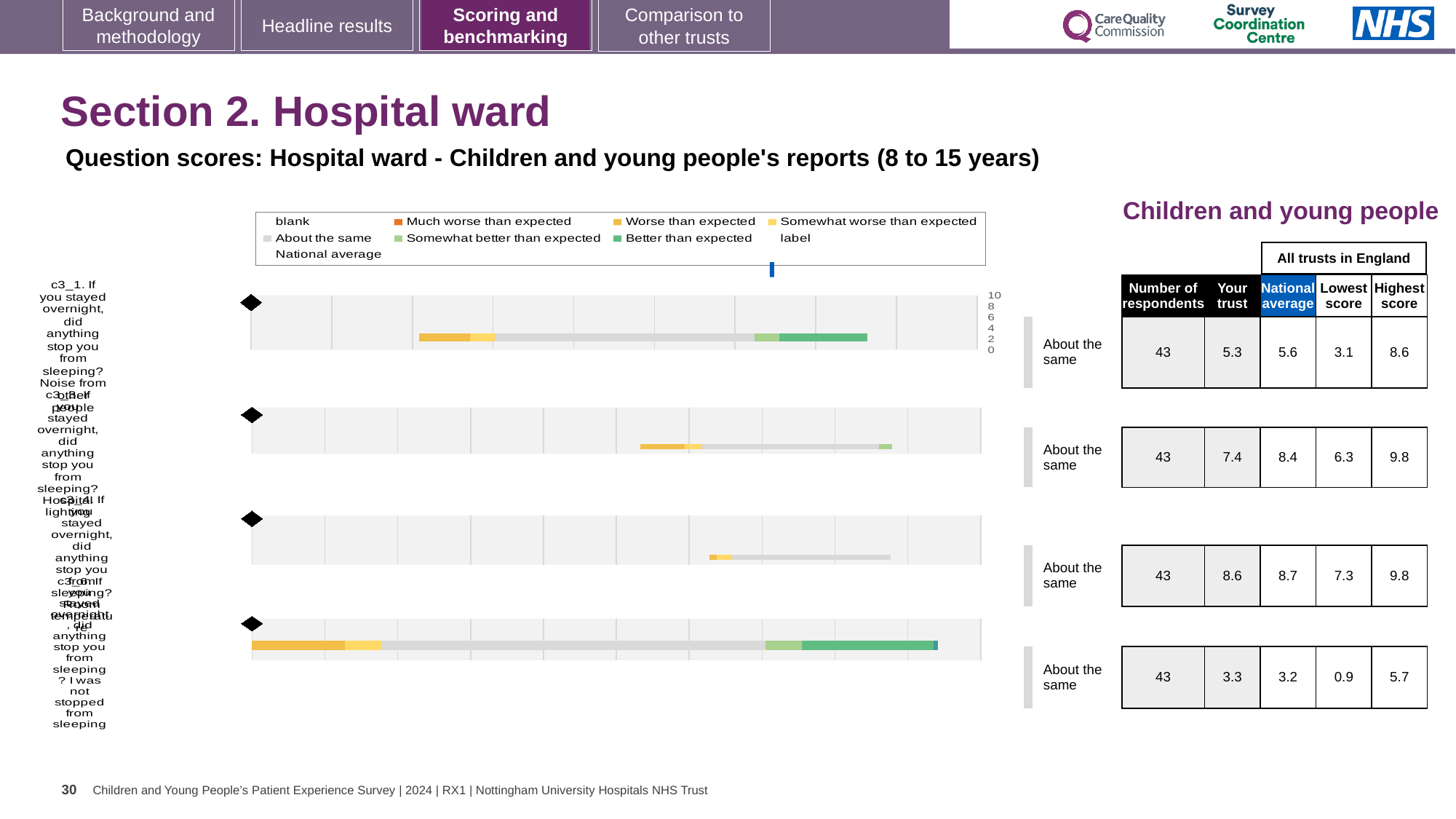
In the chart legend, what colour represents 'Better than expected'? green For the fourth (bottom) chart, what is the lowest score across all trusts in England shown in the table beside it? 0.9 For the first (top) chart, what is the 'Your trust' score shown in the table beside it? 5.3 What kind of chart is used on this slide to show the question scores? bar chart For the second chart, what is the highest score across all trusts in England shown in the table beside it? 9.8 How many separate bar charts are shown on the slide? 4 How many respondents are listed for the third chart in the table beside it? 43 For the fourth (bottom) chart, what is the difference between the 'Your trust' score and the national average? 0.1 What benchmark category is shown next to each of the four charts? About the same For the first (top) chart, what is the national average shown in the table beside it? 5.6 For the second chart, which is larger: the 'Your trust' score or the national average? National average In the chart legend, what colour represents 'Much worse than expected'? orange